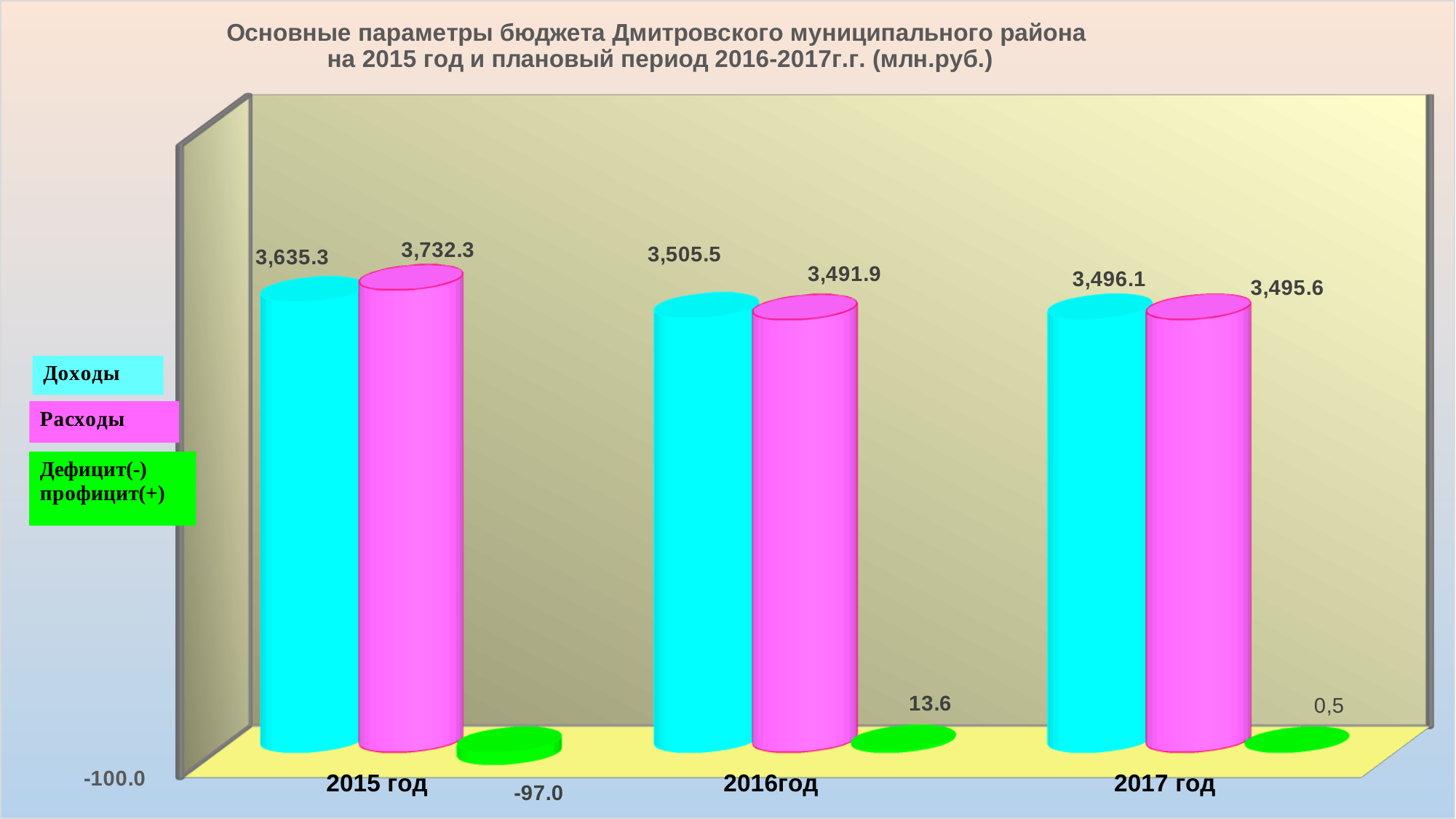
What is the difference between Расходы and Доходы in 2015 год? 97.0 In which year is Расходы the highest? 2015 год What is the value of Дефицит(-) профицит(+) for 2015 год? -97.0 Which is larger in 2016год, Доходы or Расходы? Доходы What is the value of Доходы for 2015 год? 3,635.3 How many series does the legend list? 3 What is the value of Расходы for 2016год? 3,491.9 Which colour represents Доходы in the legend? Cyan What is the value of Дефицит(-) профицит(+) for 2017 год? 0,5 What kind of chart is shown on the slide? Bar chart In which year is Доходы the lowest? 2017 год How many years are shown on the x axis? 3